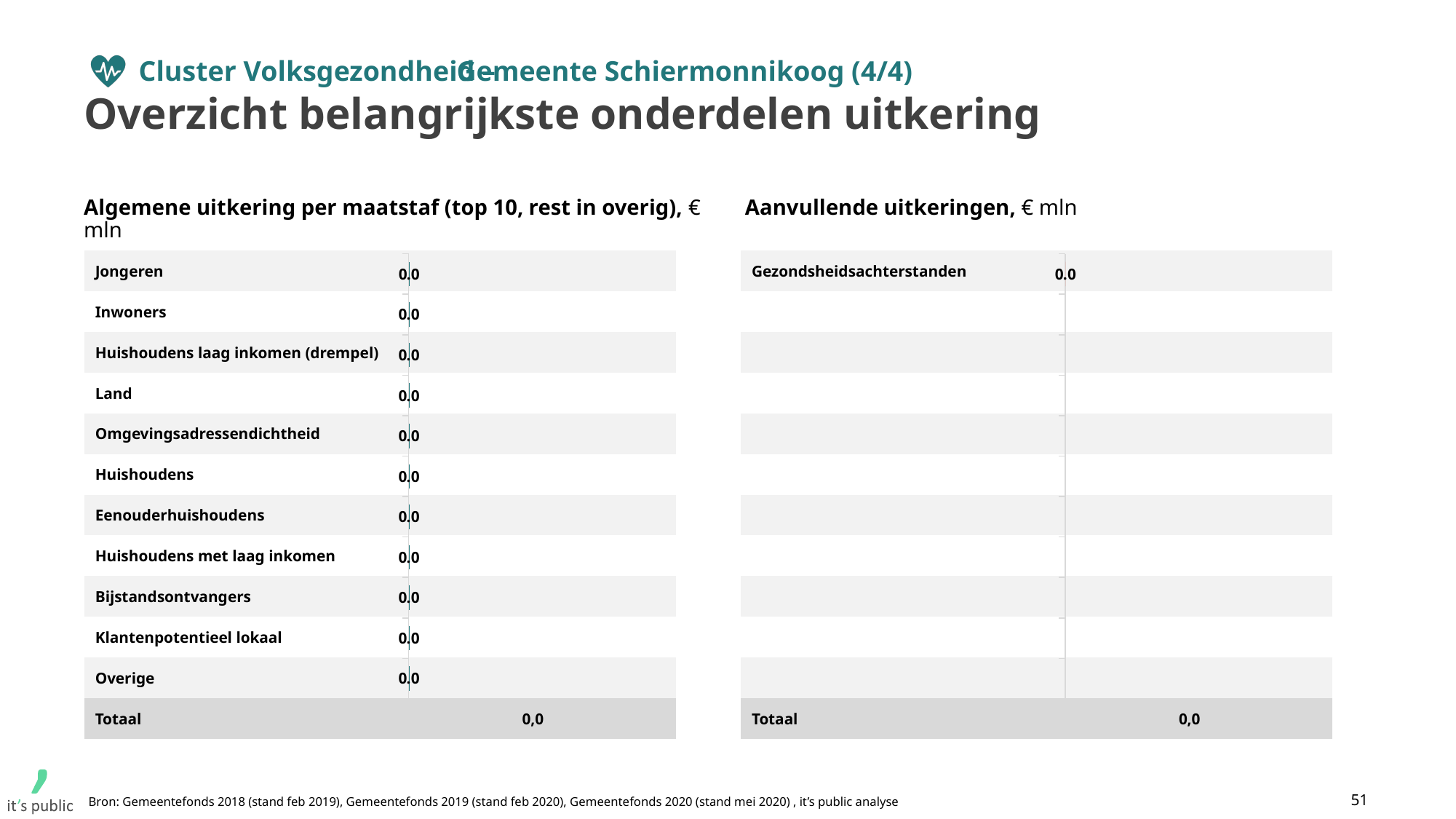
In the chart 'Algemene uitkering per maatstaf (top 10, rest in overig)', what is the value for Bijstandsontvangers? 0.0 In the chart 'Algemene uitkering per maatstaf (top 10, rest in overig)', what is the value for Overige? 0.0 In the chart 'Algemene uitkering per maatstaf (top 10, rest in overig)', what is the difference between the values for Inwoners and Land? 0.0 In the chart 'Aanvullende uitkeringen', what is the Totaal value? 0,0 In what unit are the values in the chart 'Aanvullende uitkeringen' expressed? € mln In the chart 'Algemene uitkering per maatstaf (top 10, rest in overig)', what is the value for Klantenpotentieel lokaal? 0.0 What kind of chart is the chart 'Algemene uitkering per maatstaf (top 10, rest in overig)'? bar chart In the chart 'Algemene uitkering per maatstaf (top 10, rest in overig)', how many categories are plotted (excluding the Totaal row)? 11 In the chart 'Algemene uitkering per maatstaf (top 10, rest in overig)', what is the value for Jongeren? 0.0 In the chart 'Aanvullende uitkeringen', what is the value for Gezondsheidsachterstanden? 0.0 In the chart 'Aanvullende uitkeringen', how many categories are plotted (excluding the Totaal row)? 1 In the chart 'Algemene uitkering per maatstaf (top 10, rest in overig)', what is the Totaal value? 0,0